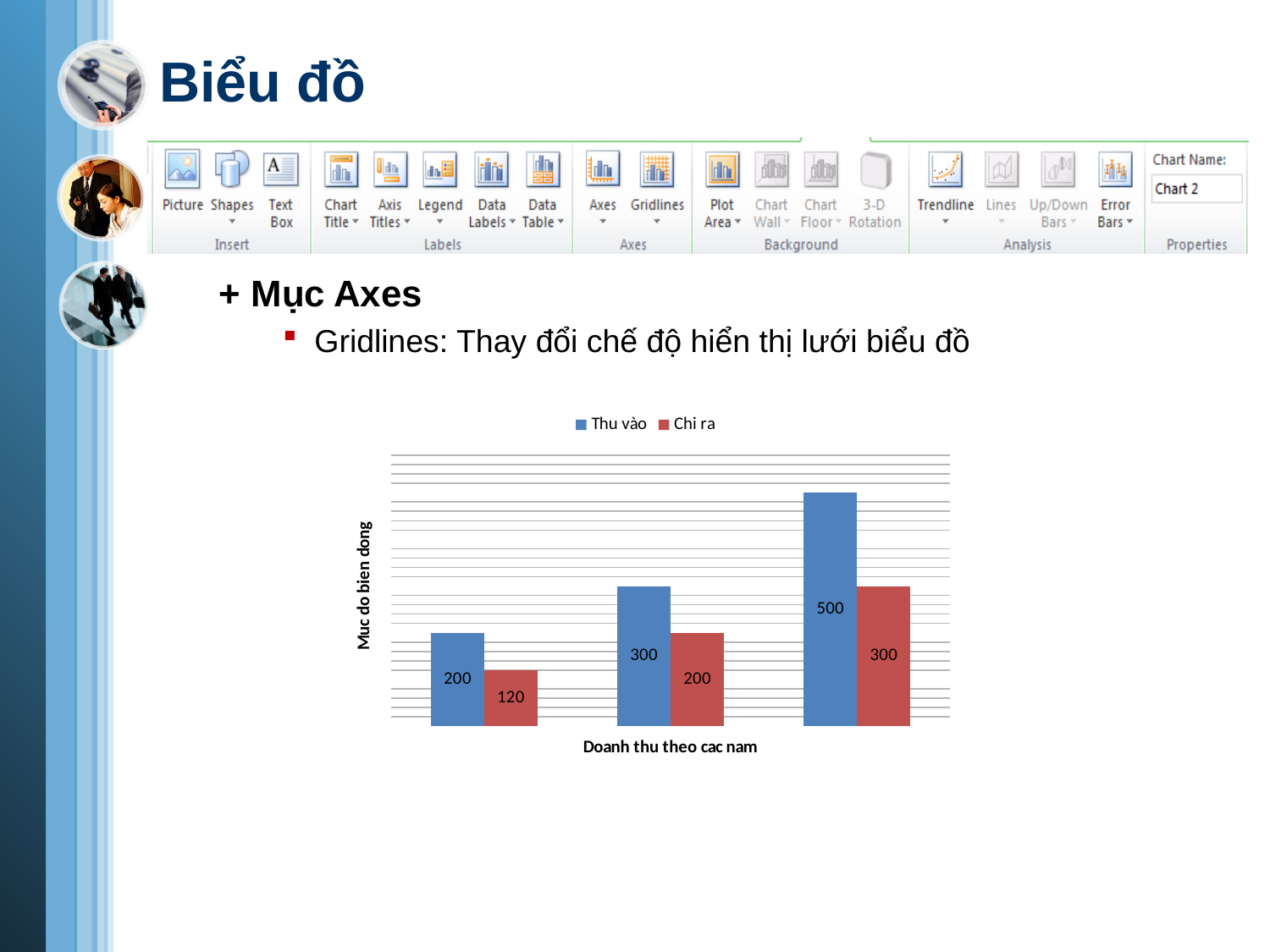
Do the Thu vào values rise or fall from the first group to the third group? rise What is the value of the Thu vào bar in the third group? 500 How many series does the chart legend list? 2 How many groups of bars are plotted in the chart? 3 What is the value of the Thu vào bar in the first group? 200 Which group has the lowest Chi ra value? the first group What is the value of the Chi ra bar in the first group? 120 What is the value of the Chi ra bar in the second group? 200 What kind of chart is shown on the slide? bar chart What is the difference between Thu vào and Chi ra in the third group? 200 Which group has the highest Thu vào value? the third group What is the title of the vertical axis of the chart? Muc do bien dong